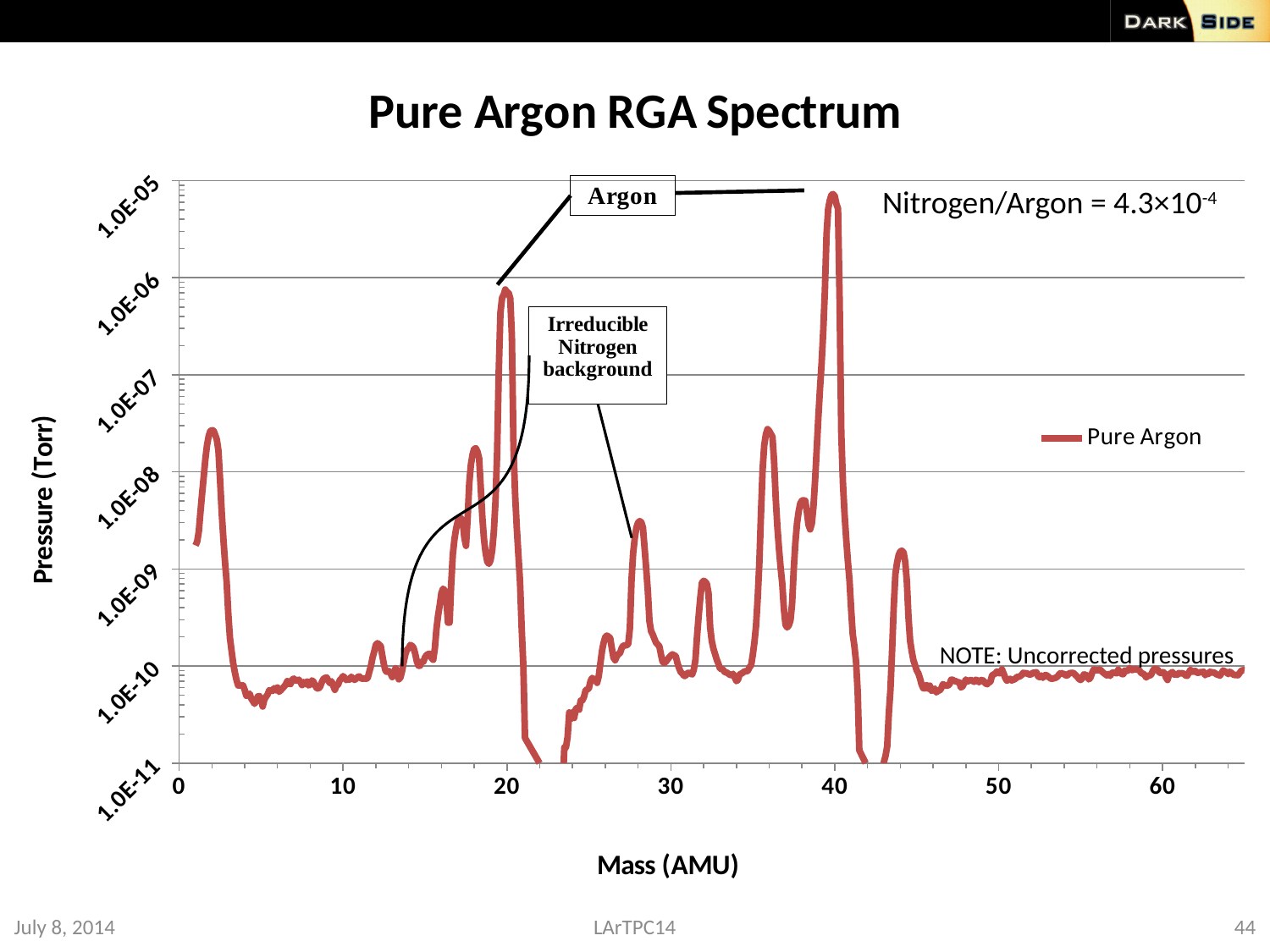
How many series does the legend list? 1 Is the peak pressure near mass 2 AMU greater or less than 1.0E-08 Torr? greater Is the peak pressure at mass 28 AMU greater or less than 1.0E-08 Torr? less What is the name of the series shown in the legend? Pure Argon Is the peak pressure at mass 40 AMU greater or less than 1.0E-06 Torr? greater What is the title of the chart? Pure Argon RGA Spectrum At which mass (AMU) does the spectrum reach its highest peak? 40 Which peak is larger, the one at mass 28 AMU or the one at mass 36 AMU? mass 36 AMU Which peak is larger, the one at mass 40 AMU or the one at mass 20 AMU? mass 40 AMU What kind of chart is shown on the slide? line chart What is the lowest value shown on the Pressure (Torr) axis? 1.0E-11